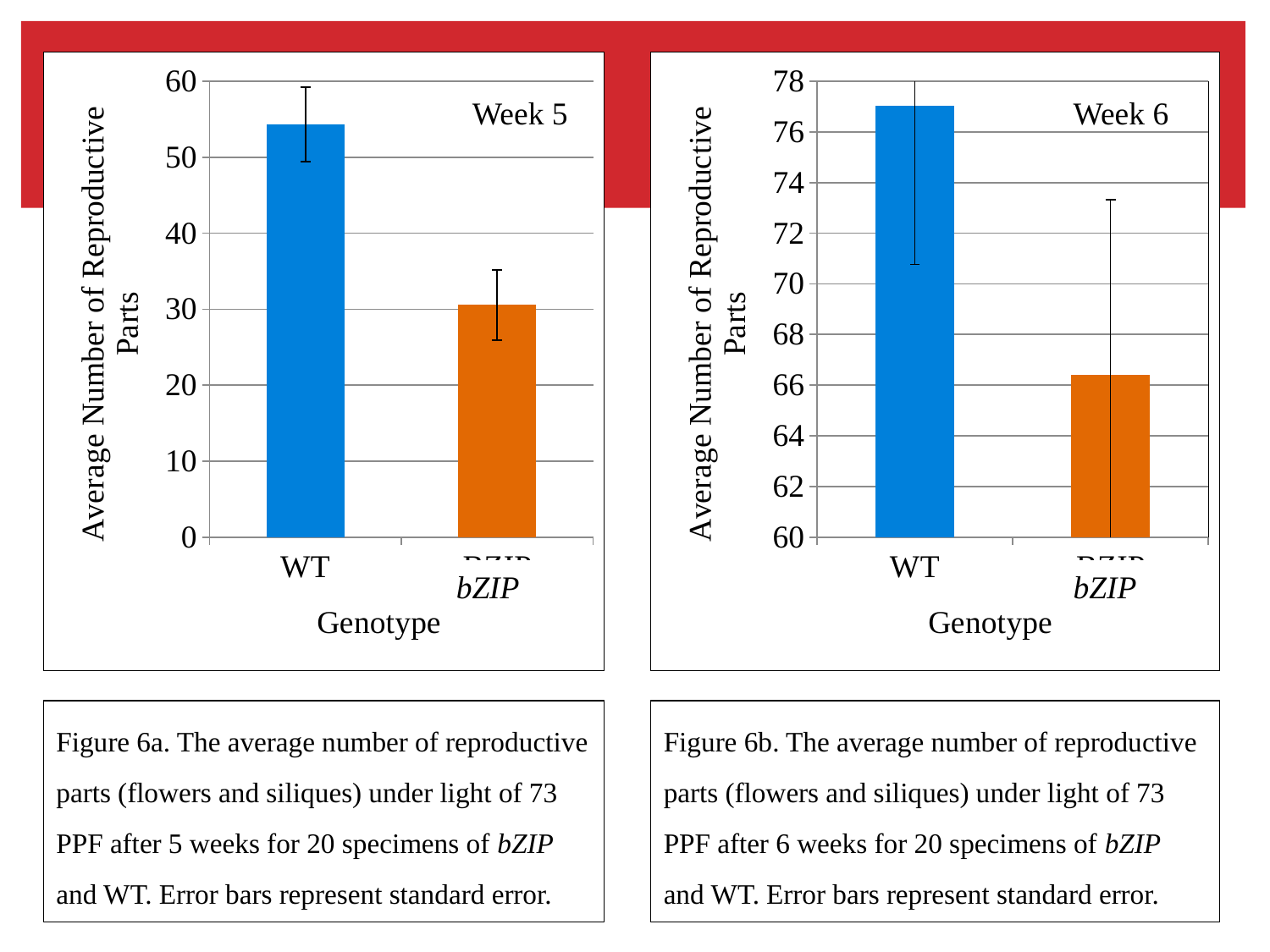
How many genotype categories are shown in the Week 6 chart? 2 What is the x-axis label of the Week 5 chart? Genotype In the Week 5 chart, is the value for WT greater or less than 50? greater In the Week 6 chart, is the value for bZIP larger or smaller than the value for WT? smaller In the Week 5 chart, is the value for bZIP greater or less than 40? less In the Week 6 chart, is the value for WT greater or less than 74? greater In the Week 6 chart, which genotype has the higher average number of reproductive parts? WT In the Week 5 chart, which genotype has the higher average number of reproductive parts? WT What kind of chart is the Week 5 chart? bar chart In the Week 5 chart, which genotype has the lower average number of reproductive parts? bZIP What is the y-axis label of the Week 6 chart? Average Number of Reproductive Parts